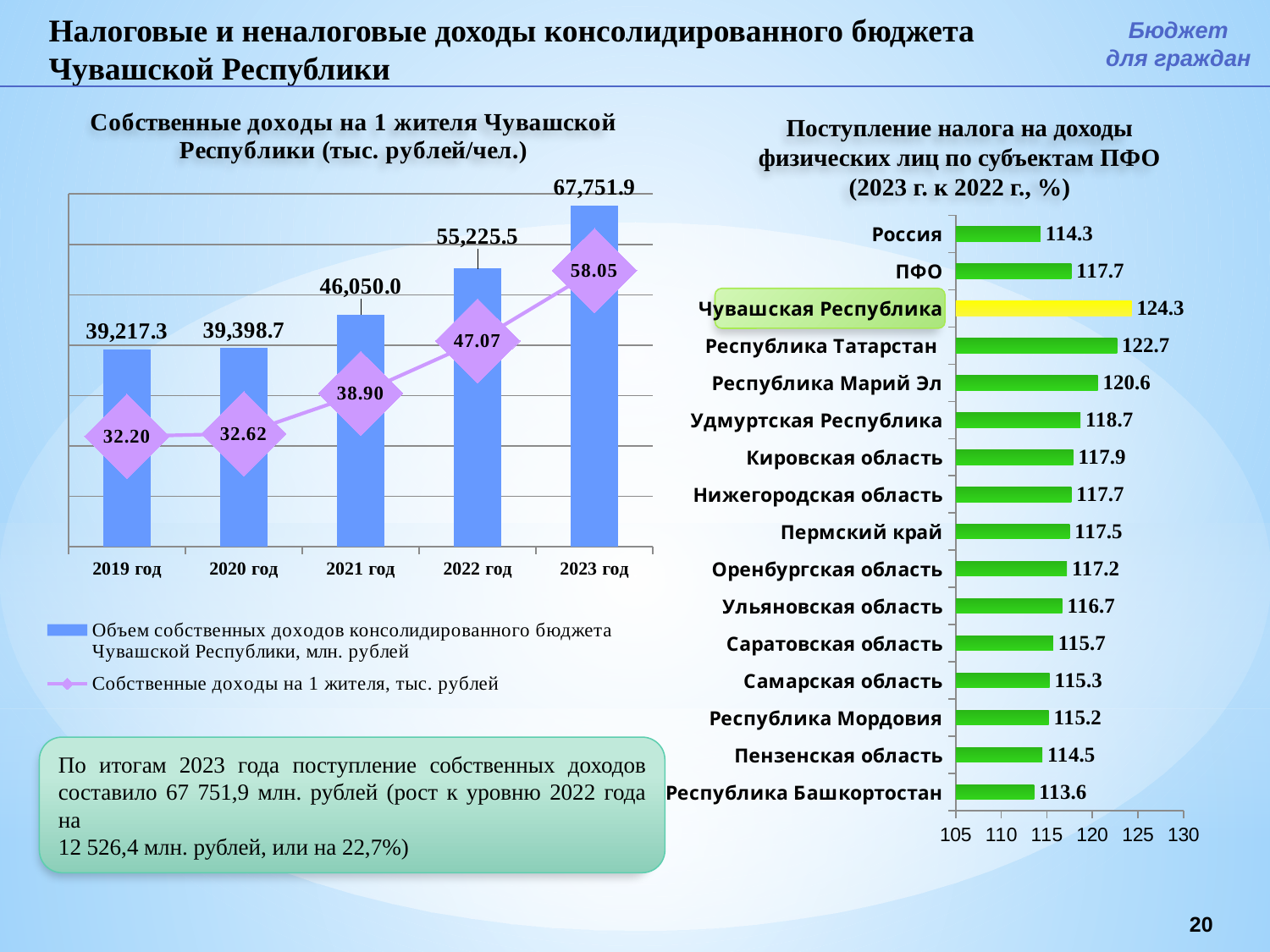
On the right chart (Поступление налога на доходы физических лиц по субъектам ПФО), what is the value for Чувашская Республика? 124.3 On the right chart, which is larger: the value for Республика Татарстан or the value for Республика Марий Эл? Республика Татарстан What type of chart is the right chart? bar chart On the left chart (Собственные доходы на 1 жителя Чувашской Республики), what is the value of the bar for 2023 год? 67,751.9 On the left chart, how many series does the legend list? 2 On the right chart, which region has the lowest value? Республика Башкортостан On the left chart, what is the value of the line marker (Собственные доходы на 1 жителя) for 2021 год? 38.90 On the left chart, do the bar values rise or fall from 2019 год to 2023 год? rise On the right chart, what is the difference between the values for Чувашская Республика and Россия? 10.0 On the right chart, which region has the highest value? Чувашская Республика On the left chart, what is the difference between the bar values for 2023 год and 2022 год? 12,526.4 On the left chart, how many years are shown on the x axis? 5